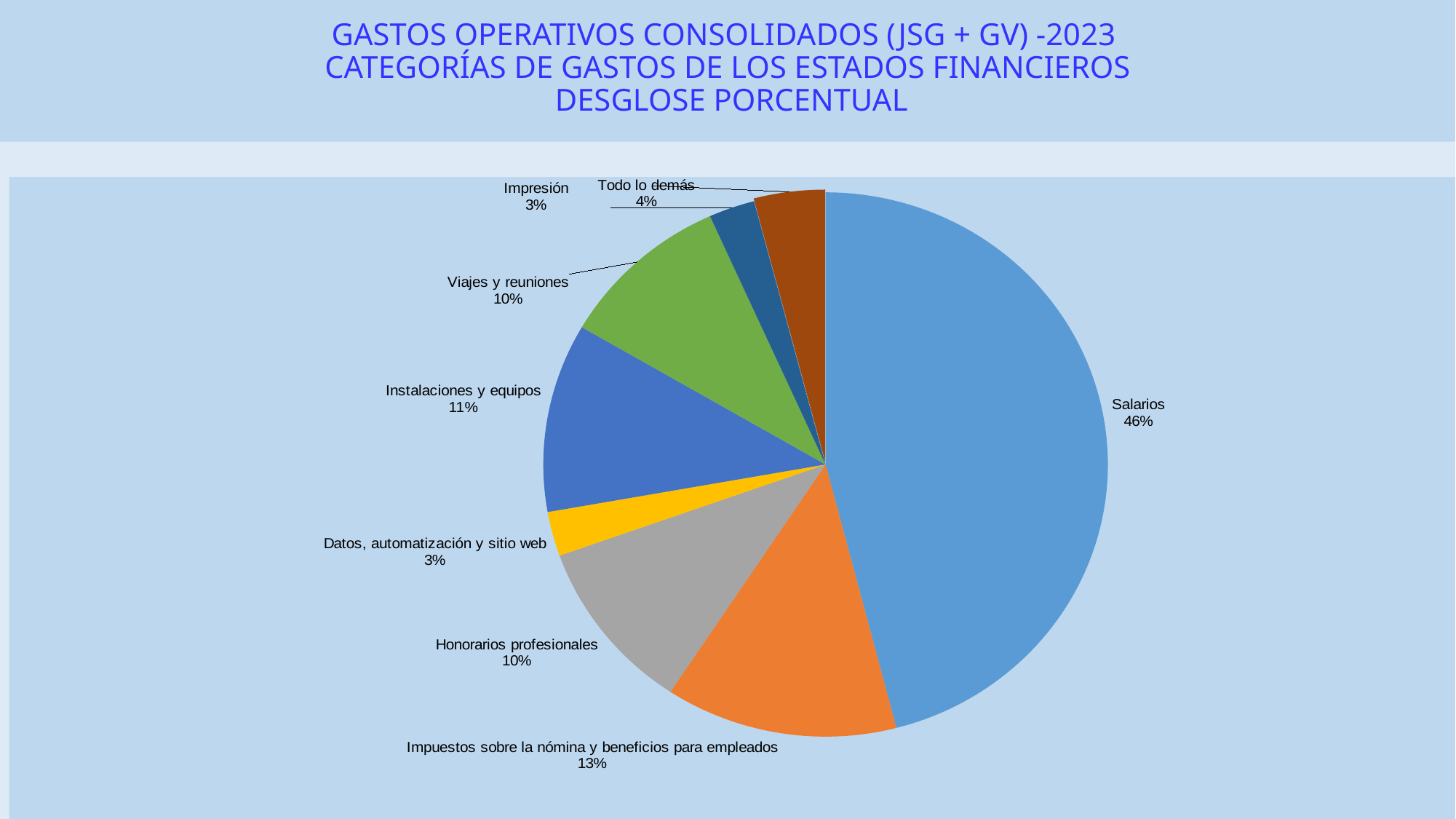
What kind of chart is shown on the slide? Pie chart What share of the pie does Salarios represent? 46% What year is mentioned in the chart title? 2023 What percentage is shown for Impuestos sobre la nómina y beneficios para empleados? 13% What percentage is shown for Todo lo demás? 4% What percentage is shown for Instalaciones y equipos? 11% What is the difference in percentage points between Salarios and Impuestos sobre la nómina y beneficios para empleados? 33 Which is larger, Todo lo demás or Impresión? Todo lo demás What is the difference in percentage points between Honorarios profesionales and Datos, automatización y sitio web? 7 How many categories (slices) does the pie chart have? 8 Which is larger, Instalaciones y equipos or Viajes y reuniones? Instalaciones y equipos Which category has the largest slice of the pie? Salarios